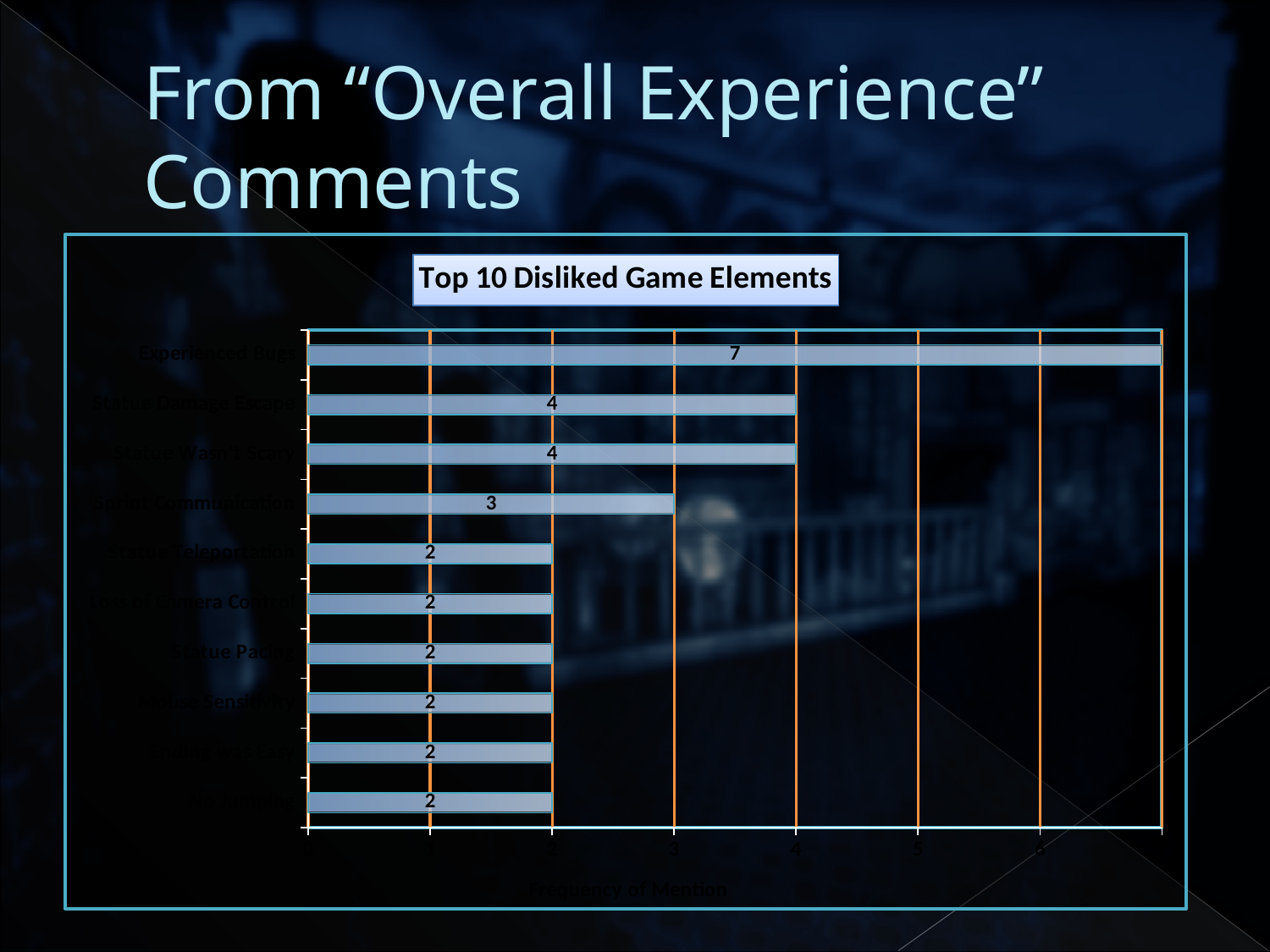
Which category has the highest frequency of mention? Experienced Bugs What is the title of the chart? Top 10 Disliked Game Elements What is the frequency of mention for Statue Damage Escape? 4 Which is larger, the value for Sprint Communication or the value for Statue Pacing? Sprint Communication What is the frequency of mention for Loss of Camera Control? 2 What is the difference between the values for Experienced Bugs and Statue Wasn't Scary? 3 What is the frequency of mention for Sprint Communication? 3 How many categories are plotted in the chart? 10 What kind of chart is shown on the slide? bar chart What is the frequency of mention for Experienced Bugs? 7 What is the label of the horizontal axis? Frequency of Mention Is the value for Experienced Bugs greater or less than 5? greater